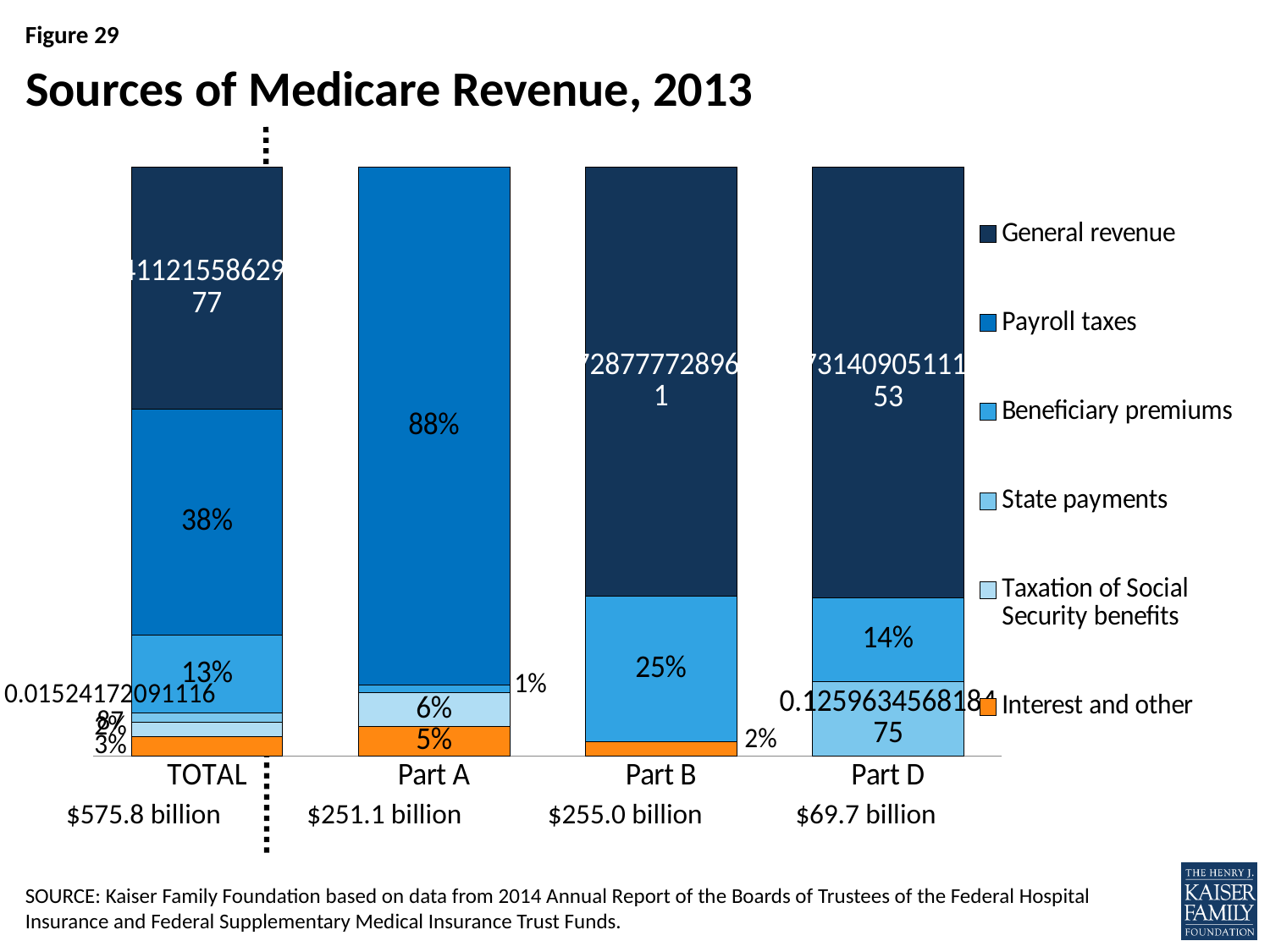
Which is larger: the beneficiary premiums share for Part B or for Part D? Part B How many series does the legend list? 6 What share of Part D revenue comes from beneficiary premiums? 14% What share of Part A revenue comes from interest and other? 5% Which part has the smallest total revenue amount shown beneath its bar? Part D How many bars (categories) are shown in the chart? 4 What is the total revenue amount shown under the Part B bar? $255.0 billion What share of Part A revenue comes from payroll taxes? 88% What share of Part B revenue comes from beneficiary premiums? 25% What is the difference between the payroll taxes share for Part A and for TOTAL? 50% What share of TOTAL Medicare revenue comes from payroll taxes? 38% What kind of chart is shown on the slide? stacked bar chart